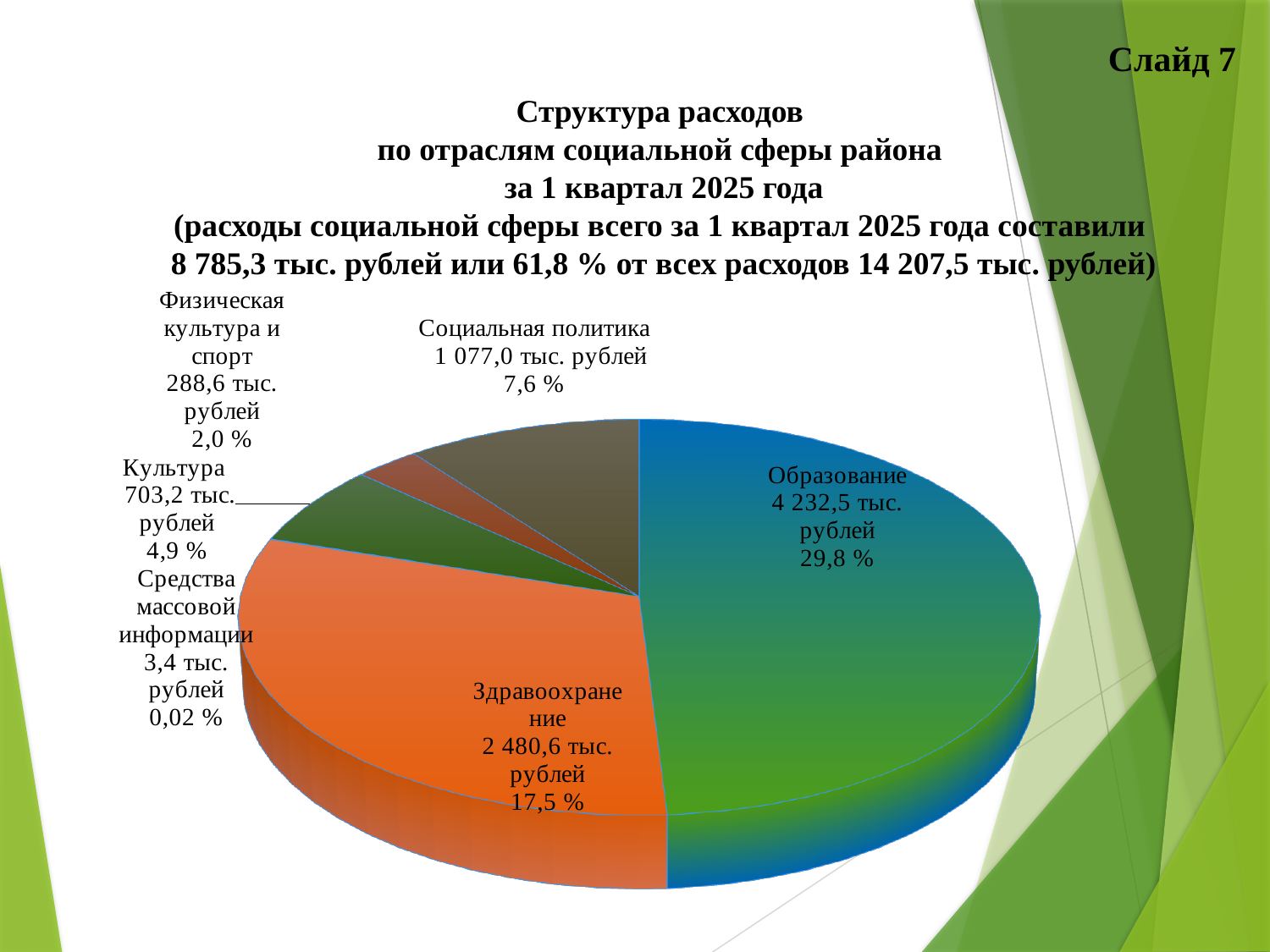
What kind of chart is shown on the slide? Pie chart Which category has the largest slice in the pie chart? Образование What is the value for Здравоохранение in the pie chart? 2 480,6 тыс. рублей What percentage is shown for Физическая культура и спорт? 2,0 % What percentage is shown for Средства массовой информации? 0,02 % What is the value for Образование in the pie chart? 4 232,5 тыс. рублей What is the value for Культура in the pie chart? 703,2 тыс. рублей How many categories (slices) does the pie chart show? 6 What is the difference between the values for Образование and Здравоохранение? 1 751,9 тыс. рублей What is the value for Социальная политика in the pie chart? 1 077,0 тыс. рублей Which category has the smallest slice in the pie chart? Средства массовой информации Which is larger, the value for Культура or the value for Социальная политика? Социальная политика